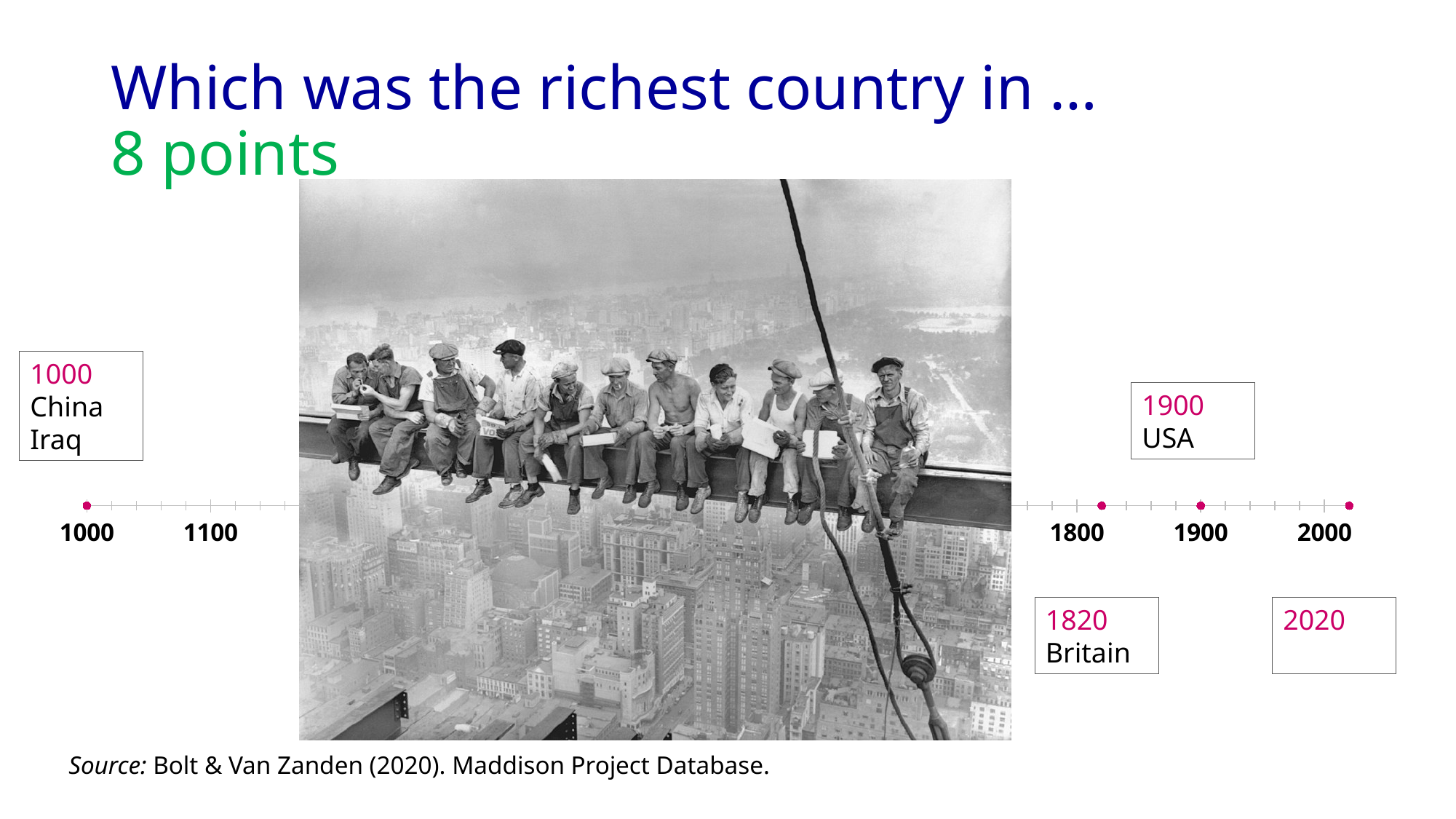
On the timeline, which year's box has no country filled in? 2020 On the timeline, which country is listed in the box for the year 1820? Britain What kind of chart is shown on the slide? timeline What colour are the year labels inside the timeline boxes? pink Which year box on the timeline comes first: 1820 Britain or 1900 USA? 1820 Britain On the timeline, which country is listed in the box for the year 1900? USA What is the source cited below the timeline? Bolt & Van Zanden (2020). Maddison Project Database. On the timeline, which countries are listed in the box for the year 1000? China, Iraq What is the latest year labelled on the timeline axis? 2000 What is the earliest year labelled on the timeline axis? 1000